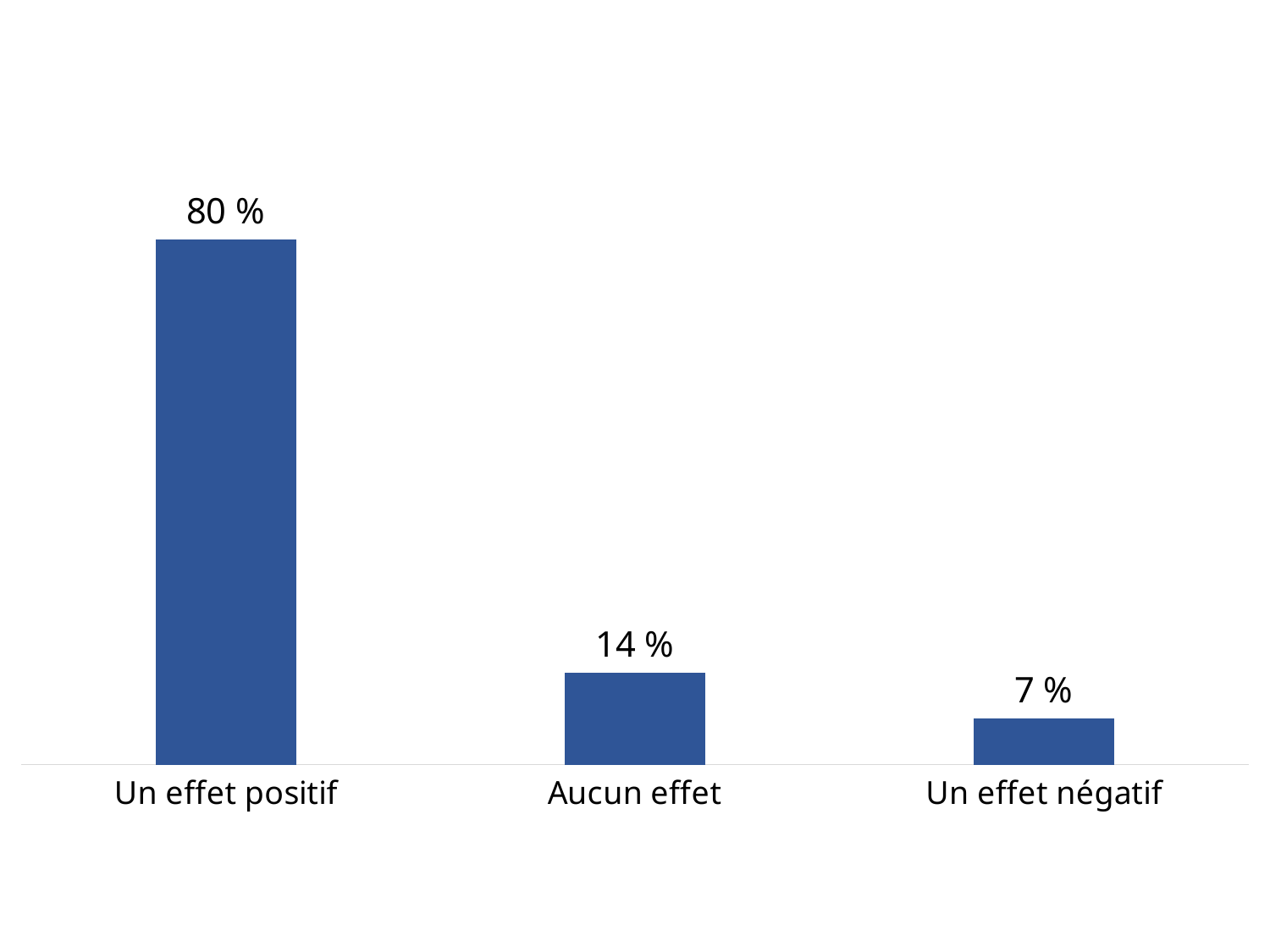
Do the values rise or fall from left to right across the categories? Fall Which category has the lowest value? Un effet négatif What is the difference between the values for "Aucun effet" and "Un effet négatif"? 7 % How many categories are shown in the chart? 3 Which is larger, the value for "Aucun effet" or the value for "Un effet négatif"? Aucun effet What is the value for "Un effet négatif"? 7 % What is the value for "Aucun effet"? 14 % What is the value for "Un effet positif"? 80 % What kind of chart is shown on the slide? Bar chart What is the difference between the values for "Un effet positif" and "Aucun effet"? 66 % What colour are the bars in the chart? Blue Which category has the highest value? Un effet positif